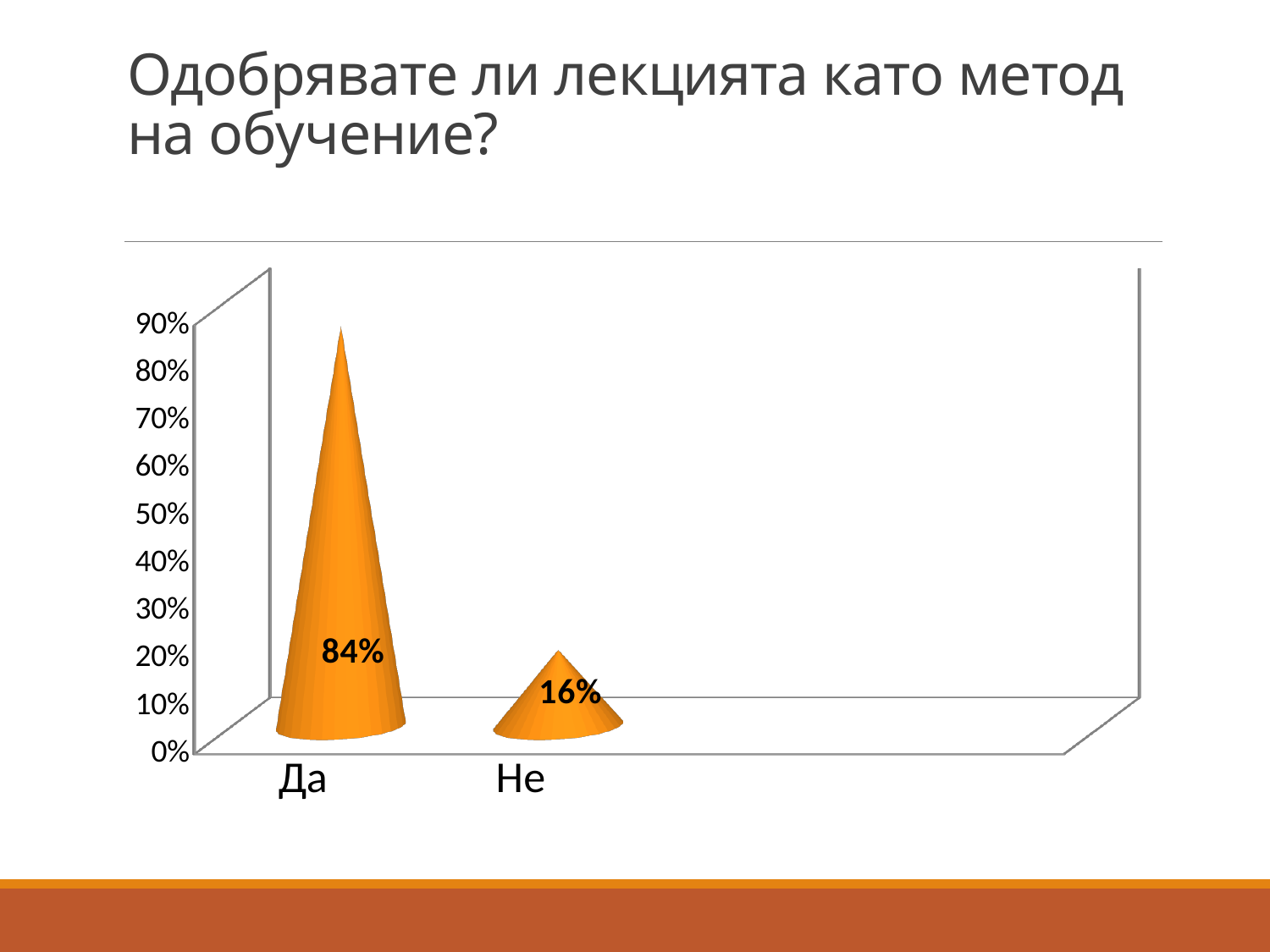
How many categories are shown on the x axis? 2 What is the total of the two values shown? 100% Is the value for Не greater or less than 30%? less Which is larger, the value for Да or the value for Не? Да Is the value for Да greater or less than 50%? greater What is the value for Да? 84% What kind of chart is shown on the slide? bar chart Which category has the lowest value? Не What is the value for Не? 16% What is the difference between the values for Да and Не? 68% What is the highest value shown on the vertical axis? 90% Which category has the highest value? Да